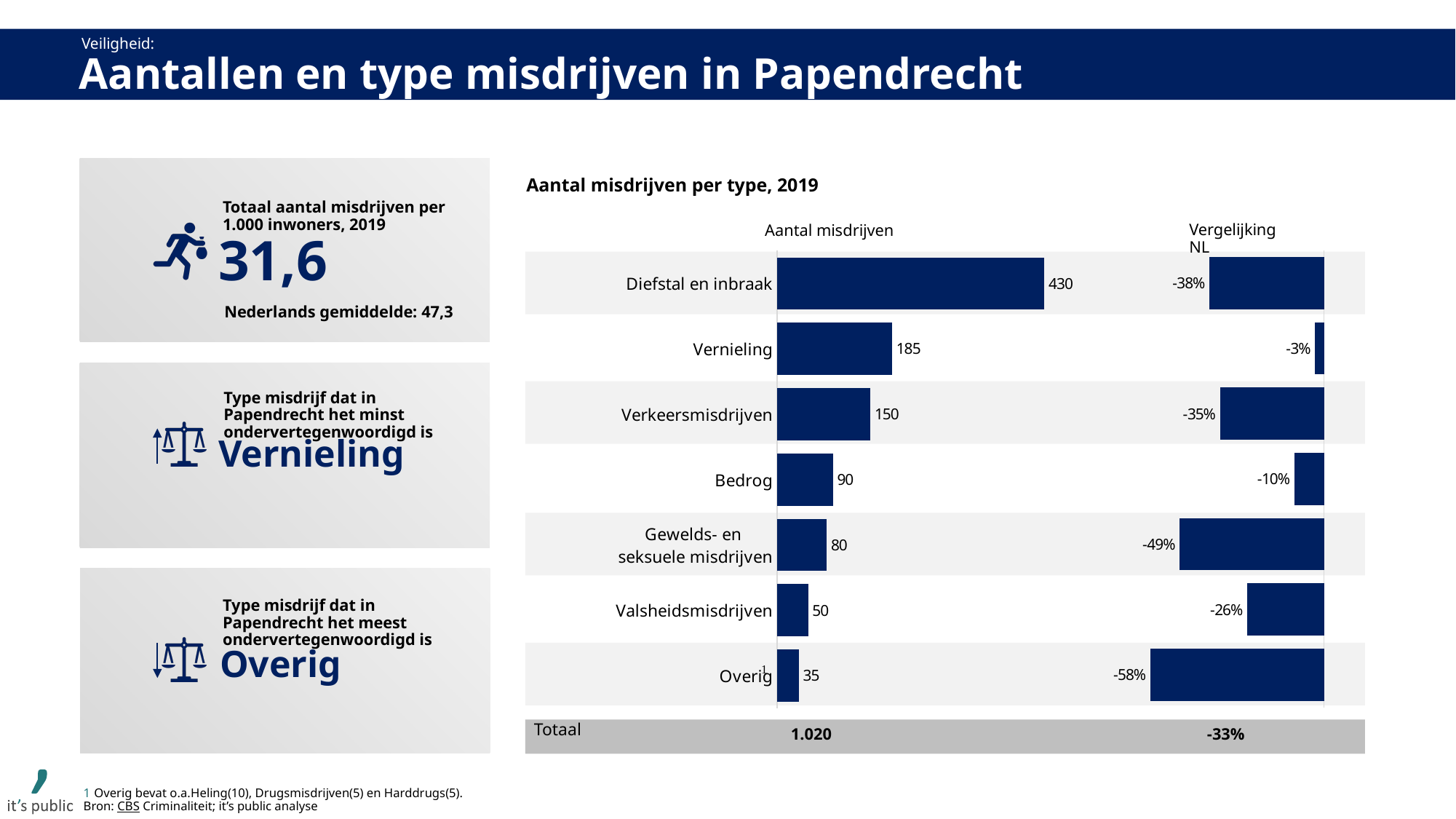
In the chart 'Aantal misdrijven per type, 2019', what is the 'Vergelijking NL' value for Gewelds- en seksuele misdrijven? -49% In the chart 'Aantal misdrijven per type, 2019', which crime type has the highest 'Aantal misdrijven'? Diefstal en inbraak In the chart 'Aantal misdrijven per type, 2019', what is the 'Vergelijking NL' value for Vernieling? -3% In the chart 'Aantal misdrijven per type, 2019', what is the Totaal value for 'Vergelijking NL'? -33% What type of chart is 'Aantal misdrijven per type, 2019'? Bar chart In the chart 'Aantal misdrijven per type, 2019', which crime type has the lowest 'Aantal misdrijven'? Overig In the chart 'Aantal misdrijven per type, 2019', what is the difference in 'Aantal misdrijven' between Diefstal en inbraak and Vernieling? 245 In the chart 'Aantal misdrijven per type, 2019', which has a higher 'Aantal misdrijven': Verkeersmisdrijven or Valsheidsmisdrijven? Verkeersmisdrijven How many crime types (excluding the Totaal row) are shown in the chart 'Aantal misdrijven per type, 2019'? 7 In the chart 'Aantal misdrijven per type, 2019', what is the Totaal value for 'Aantal misdrijven'? 1.020 In the chart 'Aantal misdrijven per type, 2019', what is the 'Aantal misdrijven' value for Bedrog? 90 In the chart 'Aantal misdrijven per type, 2019', what is the 'Aantal misdrijven' value for Diefstal en inbraak? 430